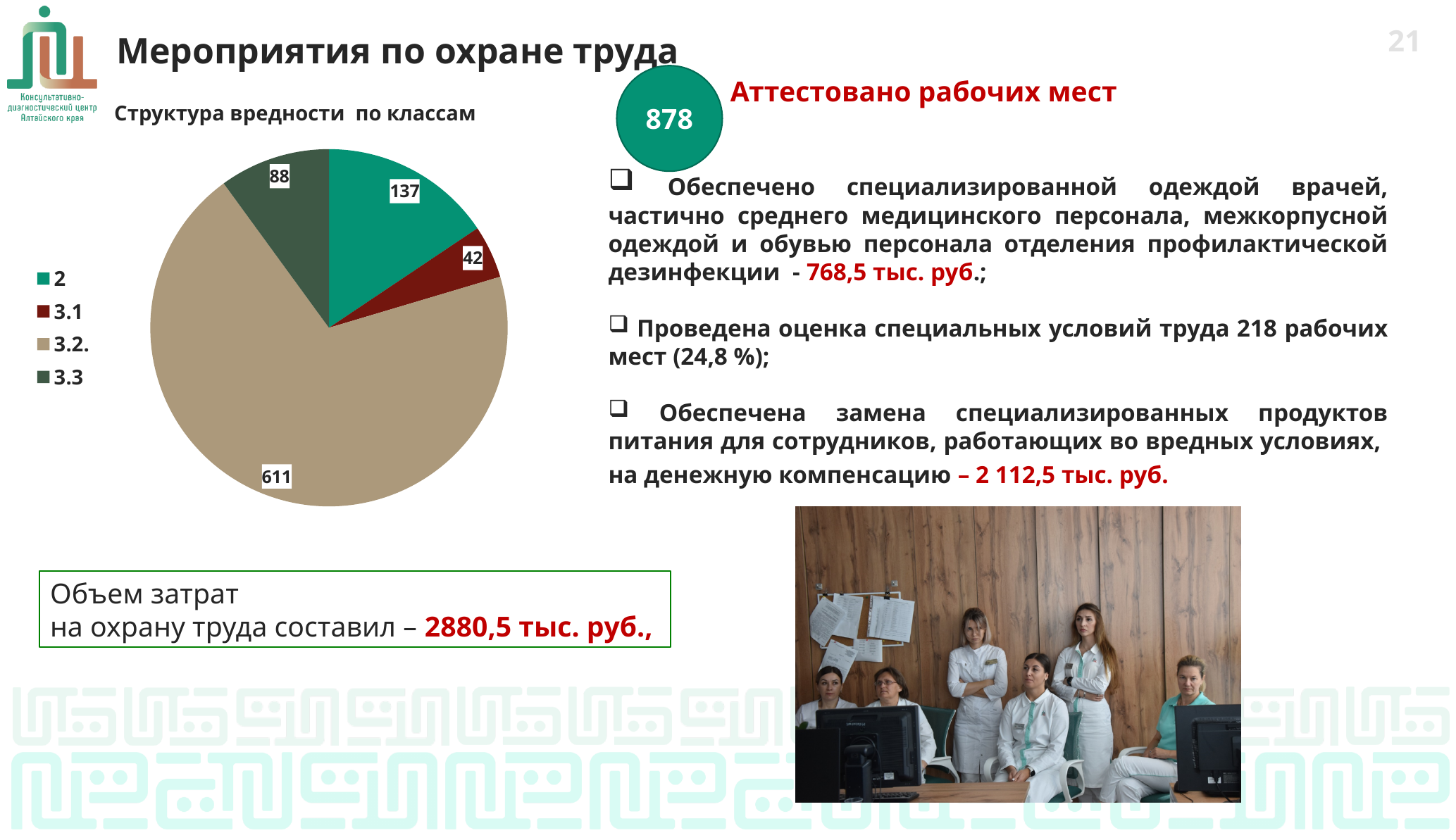
What type of chart is shown under the title "Структура вредности по классам"? pie chart How many classes (slices) are shown in the pie chart "Структура вредности по классам"? 4 In the pie chart "Структура вредности по классам", what is the value for class 2? 137 In the pie chart "Структура вредности по классам", what colour is the slice for class 3.1? dark red Which class has the smallest slice in the pie chart "Структура вредности по классам"? 3.1 In the pie chart "Структура вредности по классам", what is the value for class 3.2.? 611 In the pie chart "Структура вредности по классам", what is the value for class 3.3? 88 In the pie chart "Структура вредности по классам", what is the difference between the values for class 3.2. and class 2? 474 Which class has the largest slice in the pie chart "Структура вредности по классам"? 3.2. In the pie chart "Структура вредности по классам", which is larger: the value for class 2 or the value for class 3.3? 2 What is the total of all slices in the pie chart "Структура вредности по классам"? 878 In the pie chart "Структура вредности по классам", what is the value for class 3.1? 42